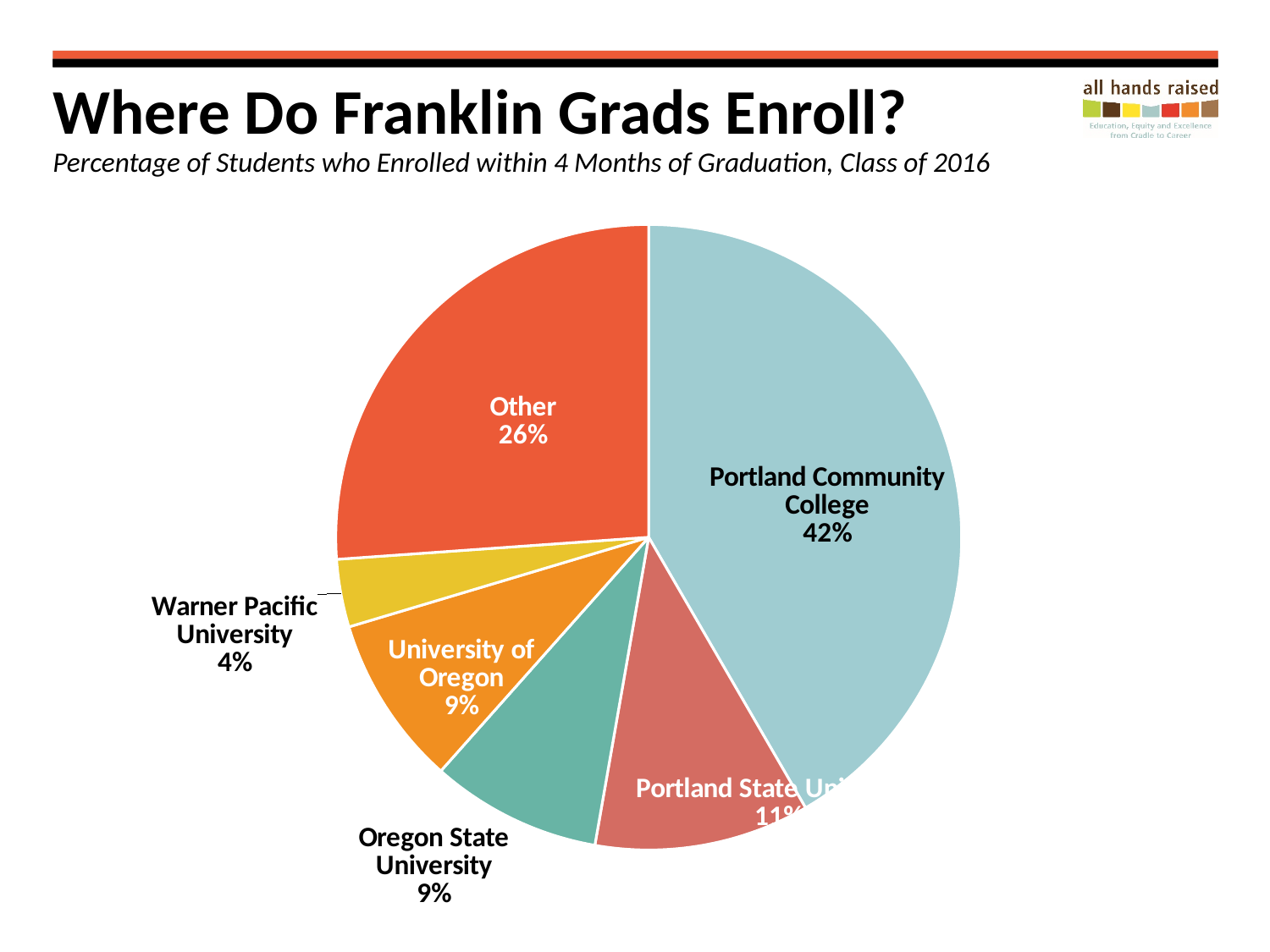
How many percentage points larger is the Portland Community College slice than the Other slice? 16 percentage points How many slices does the pie chart have? 6 What percentage of Franklin grads enrolled at Warner Pacific University? 4% What kind of chart is shown on the slide? Pie chart Which institution has the smallest slice of the pie? Warner Pacific University What percentage of Franklin grads enrolled at Oregon State University? 9% Which institution has the largest slice of the pie? Portland Community College What percentage of Franklin grads enrolled at the University of Oregon? 9% What is the title of the chart on the slide? Where Do Franklin Grads Enroll? Which is larger, the Other slice or the University of Oregon slice? Other What percentage of Franklin grads enrolled at institutions grouped as Other? 26% What percentage of Franklin grads enrolled at Portland Community College? 42%